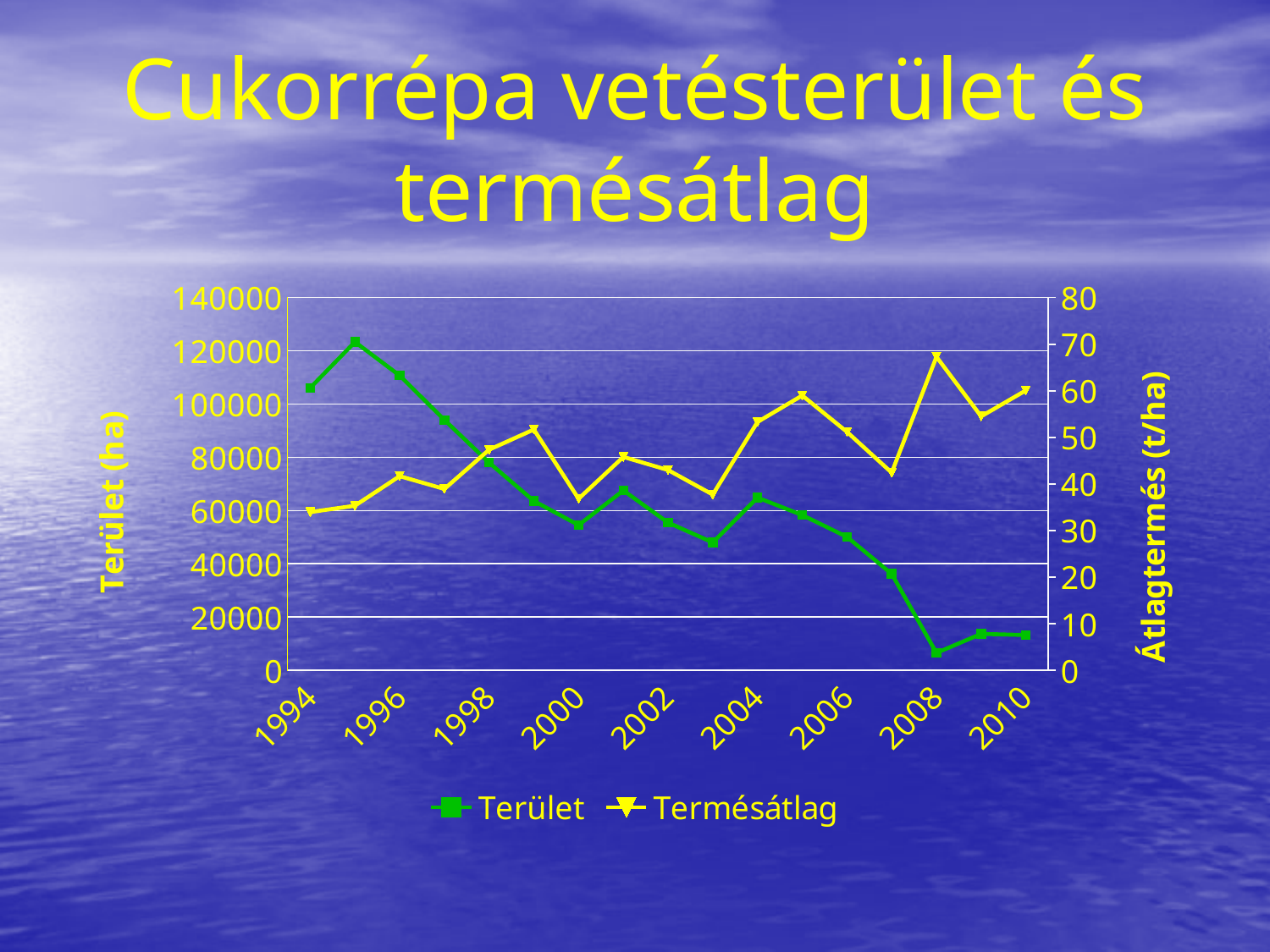
Is the Termésátlag value for 1994 greater or less than 40? less Is the Terület value for 2010 greater or less than 20000? less Is the Termésátlag value for 2008 greater or less than 60? greater Which year has the larger Terület value, 1994 or 2010? 1994 What is the title of the left vertical axis? Terület (ha) What kind of chart is shown on the slide? line chart In which year does the Termésátlag series reach its highest value? 2008 Does the Terület series overall rise or fall from 1994 to 2010? fall What are the two series named in the legend? Terület and Termésátlag In which year does the Terület series reach its lowest value? 2008 How many series does the legend list? 2